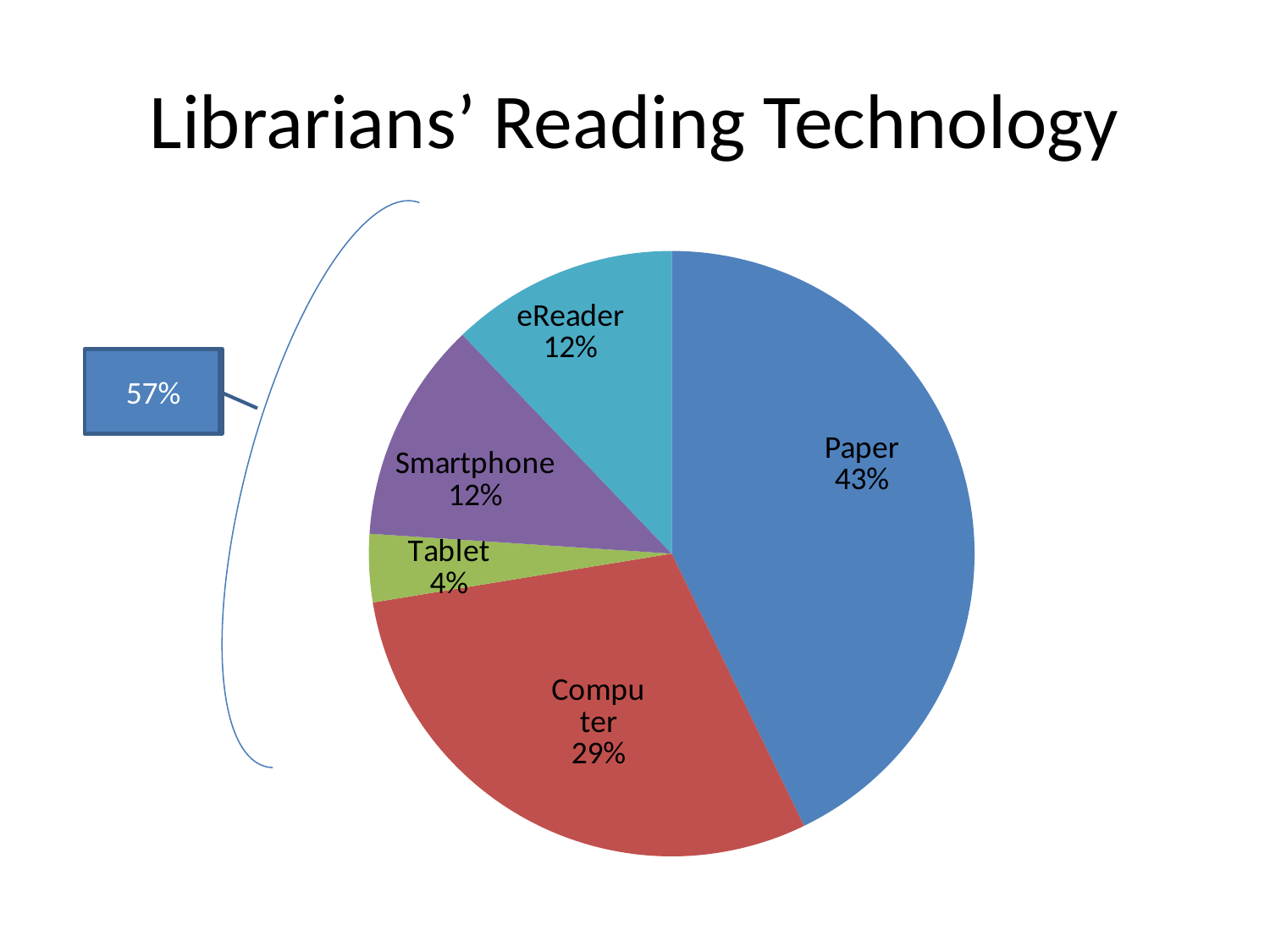
What is the value shown for Smartphone? 12% Which category has the smallest slice of the pie? Tablet What is the value shown for Tablet? 4% What is the difference between the Paper and Computer shares? 14% What kind of chart is shown on the slide? Pie chart How many categories are shown in the pie chart? 5 What share of the pie does Paper account for? 43% What is the title of the slide? Librarians' Reading Technology Which is larger, the Computer slice or the Smartphone slice? Computer Which category has the largest slice of the pie? Paper What is the value shown for Computer? 29% What is the value shown for eReader? 12%